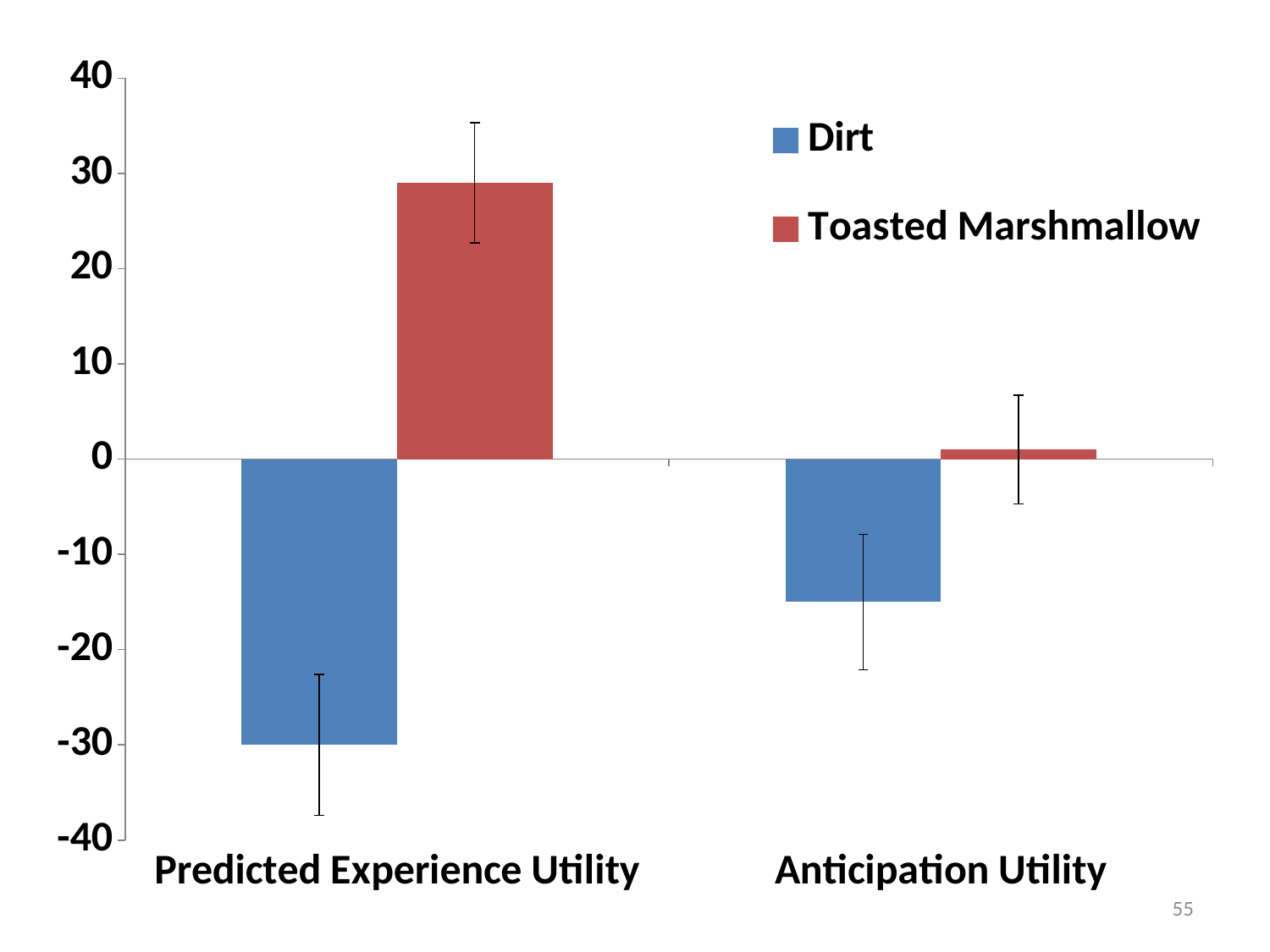
How many categories are shown on the x axis? 2 Is the Toasted Marshmallow value for Predicted Experience Utility greater or less than 20? greater In which category is the Dirt value lowest? Predicted Experience Utility Is the Dirt value for Anticipation Utility greater or less than -10? less For Predicted Experience Utility, which series has the larger value, Dirt or Toasted Marshmallow? Toasted Marshmallow What are the two series named in the legend? Dirt and Toasted Marshmallow What kind of chart is shown on the slide? bar chart For the Dirt series, which category has the larger value, Predicted Experience Utility or Anticipation Utility? Anticipation Utility In which category is the Toasted Marshmallow value highest? Predicted Experience Utility What colour are the Dirt bars? blue How many series does the legend list? 2 Is the Dirt value for Predicted Experience Utility greater or less than -20? less